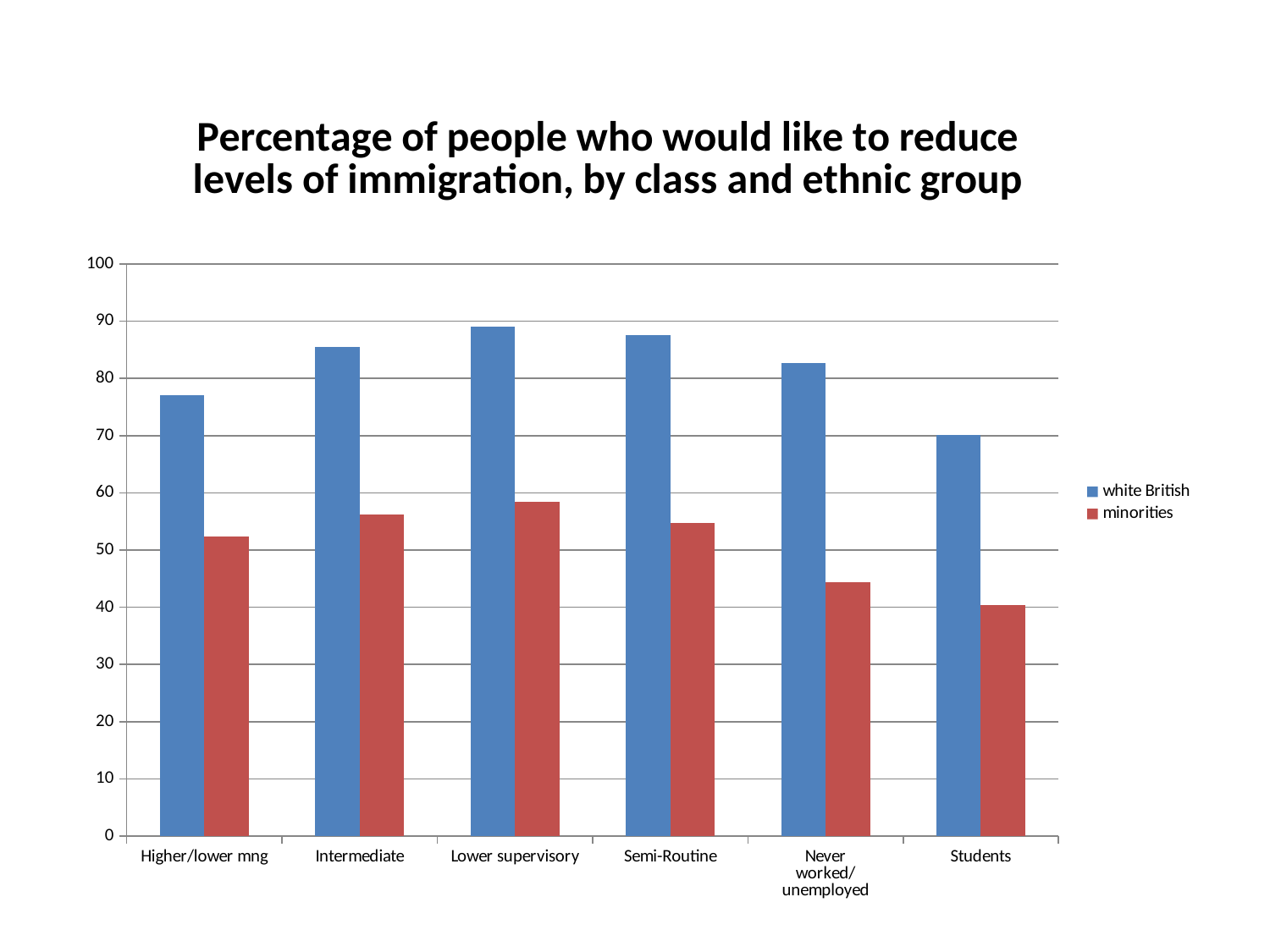
Is the value for white British in Intermediate greater or less than 80? greater How many series does the legend list? 2 How many class categories are shown on the x axis? 6 Which category has the highest value for minorities? Lower supervisory What is the title of the chart? Percentage of people who would like to reduce levels of immigration, by class and ethnic group Which category has the lowest value for white British? Students What kind of chart is shown on the slide? bar chart Is the value for white British in Higher/lower mng greater or less than 70? greater Which category has the lowest value for minorities? Students Is the value for minorities in Students greater or less than 50? less For Semi-Routine, which series has the larger value, white British or minorities? white British